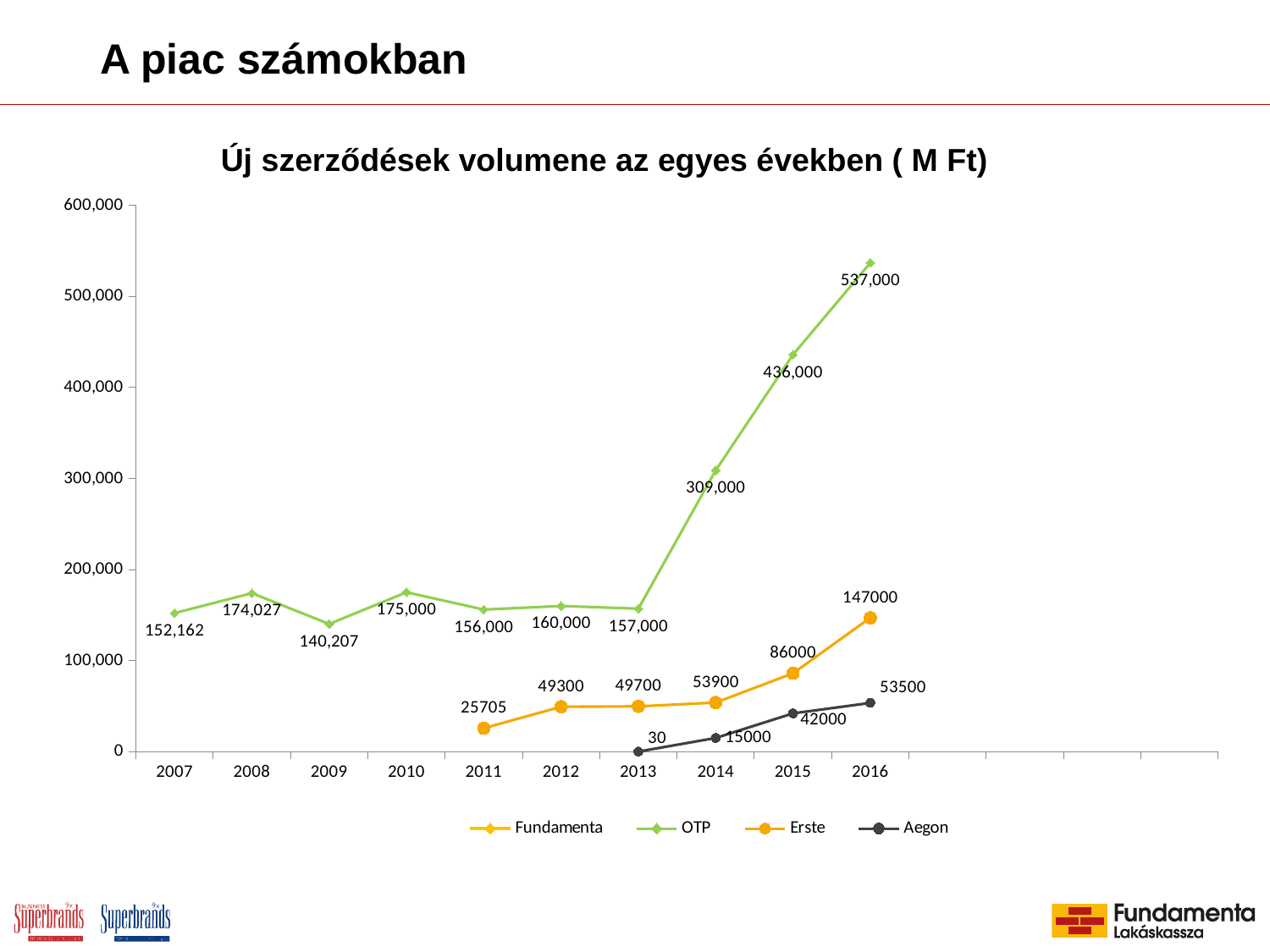
By how much did the Erste value increase from 2015 to 2016? 61000 How many years are labelled on the x axis? 10 What is the value for Erste in 2011? 25705 In which year is the OTP series at its lowest? 2009 How many series does the legend list? 4 What is the value for OTP in 2016? 537,000 What is the value for Aegon in 2015? 42000 Does the Erste series rise or fall from 2011 to 2016? Rise Which is larger in 2016, the Erste value or the Aegon value? Erste What is the difference between the OTP values for 2014 and 2013? 152,000 In which year is the OTP series at its highest? 2016 What kind of chart is shown on the slide? Line chart